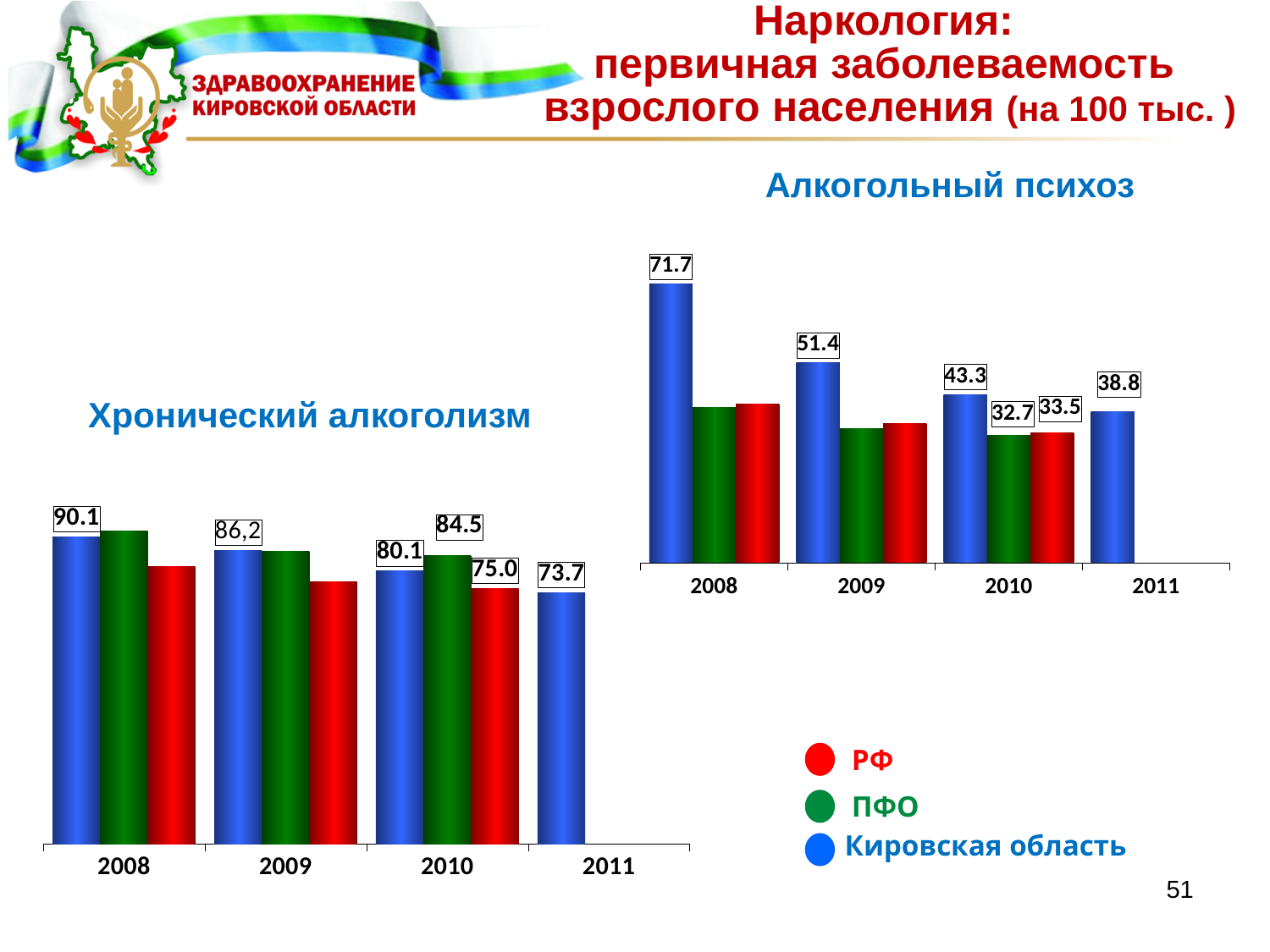
In the Хронический алкоголизм chart, what is the difference between the ПФО and РФ values in 2010? 9.5 In the Алкогольный психоз chart, by how much did the Кировская область value fall from 2008 to 2011? 32.9 How many series does the legend list? 3 In the Алкогольный психоз chart, in which year is the Кировская область value highest? 2008 In the Алкогольный психоз chart, what is the value for Кировская область in 2008? 71.7 In the Хронический алкоголизм chart, which is larger in 2010: ПФО or Кировская область? ПФО In the Хронический алкоголизм chart, what is the value for ПФО in 2010? 84.5 What kind of chart is the Хронический алкоголизм chart? bar chart In the Алкогольный психоз chart, what is the value for РФ in 2010? 33.5 In the Алкогольный психоз chart, do the Кировская область values rise or fall from 2008 to 2011? fall In the Хронический алкоголизм chart, what is the value for Кировская область in 2008? 90.1 In the Хронический алкоголизм chart, what is the value for Кировская область in 2009? 86,2